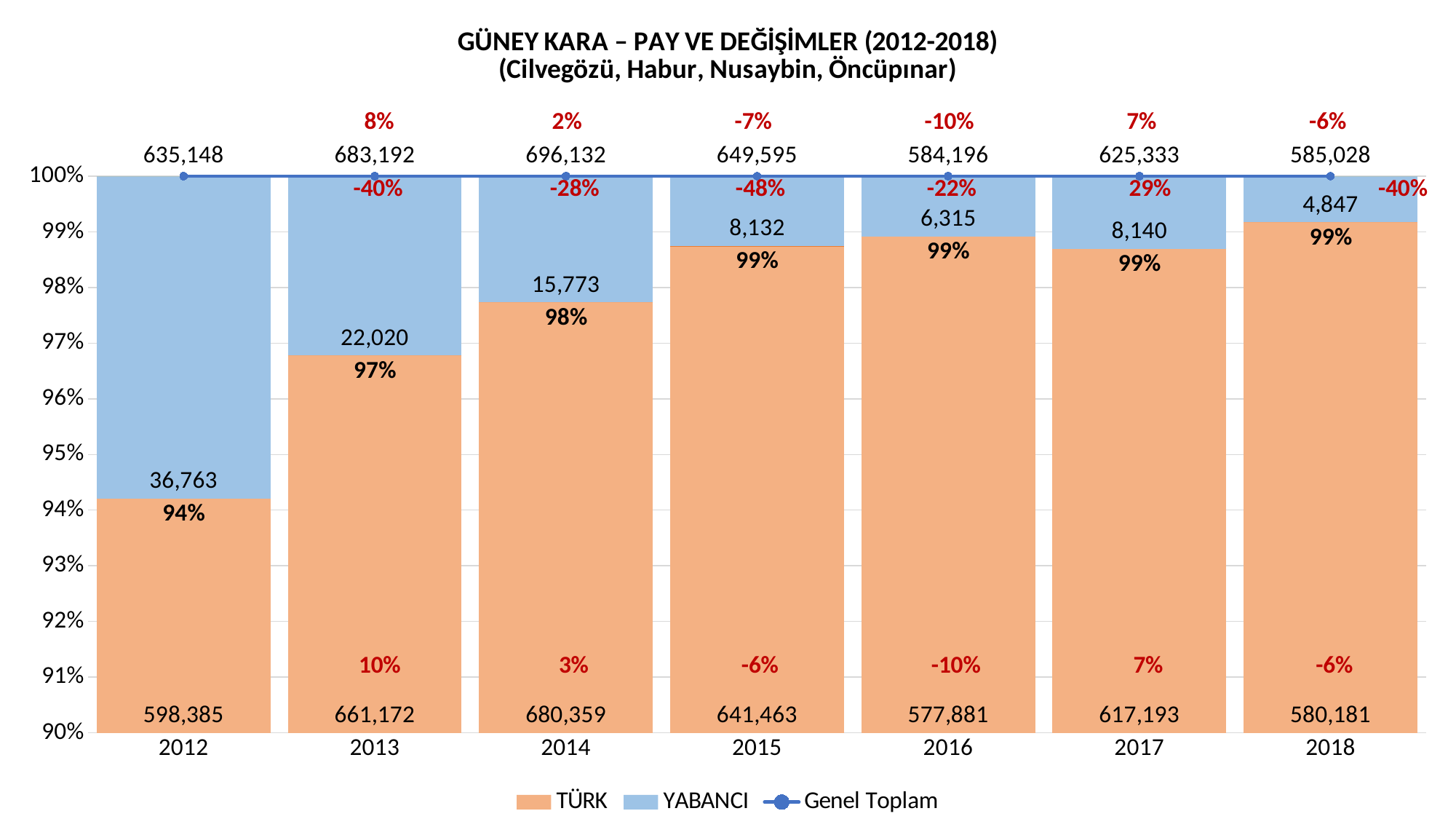
In which year is the Genel Toplam value highest? 2014 How many series does the legend list? 3 What is the TÜRK value for 2014? 680,359 How many years are shown on the x axis? 7 In which year is the YABANCI value lowest? 2018 What is the Genel Toplam value for 2016? 584,196 Do the YABANCI values rise or fall from 2012 to 2016? Fall What is the YABANCI value for 2012? 36,763 What percentage share is labelled on the TÜRK segment for 2013? 97% What kind of chart is this? Stacked bar chart with a line Which year has the larger TÜRK value, 2015 or 2017? 2015 What is the difference between the Genel Toplam values for 2014 and 2013? 12,940